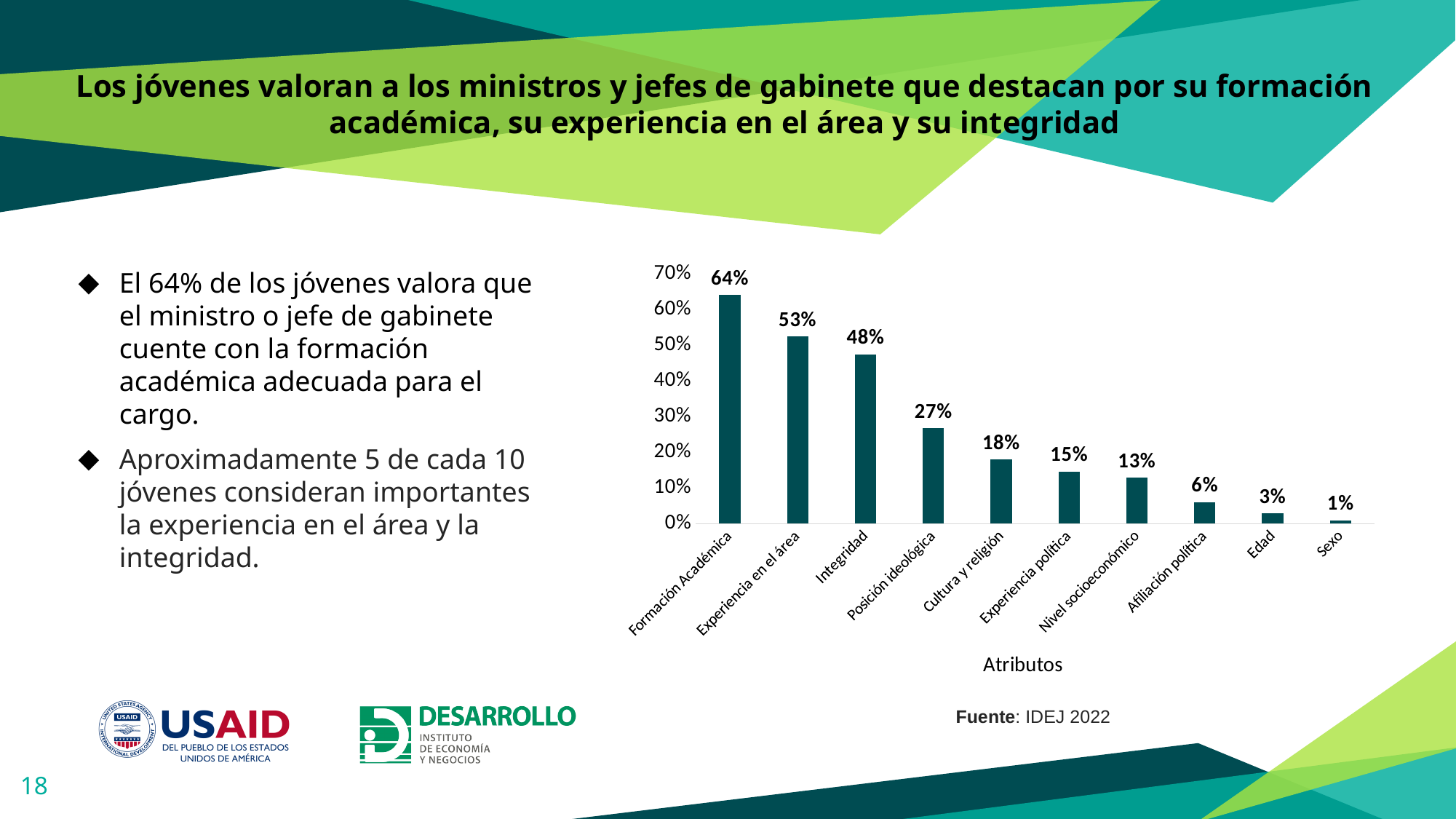
How many attributes are shown on the x axis? 10 What is the value for Afiliación política? 6% What kind of chart is shown on the slide? Bar chart Which attribute has the highest value? Formación Académica What is the value for Posición ideológica? 27% What is the x-axis title of the chart? Atributos What is the value for Integridad? 48% What is the value for Formación Académica? 64% Is the value for Nivel socioeconómico greater or less than 20%? less Which is larger, the value for Cultura y religión or the value for Experiencia política? Cultura y religión Which attribute has the lowest value? Sexo What is the difference between the values for Experiencia en el área and Integridad? 5%